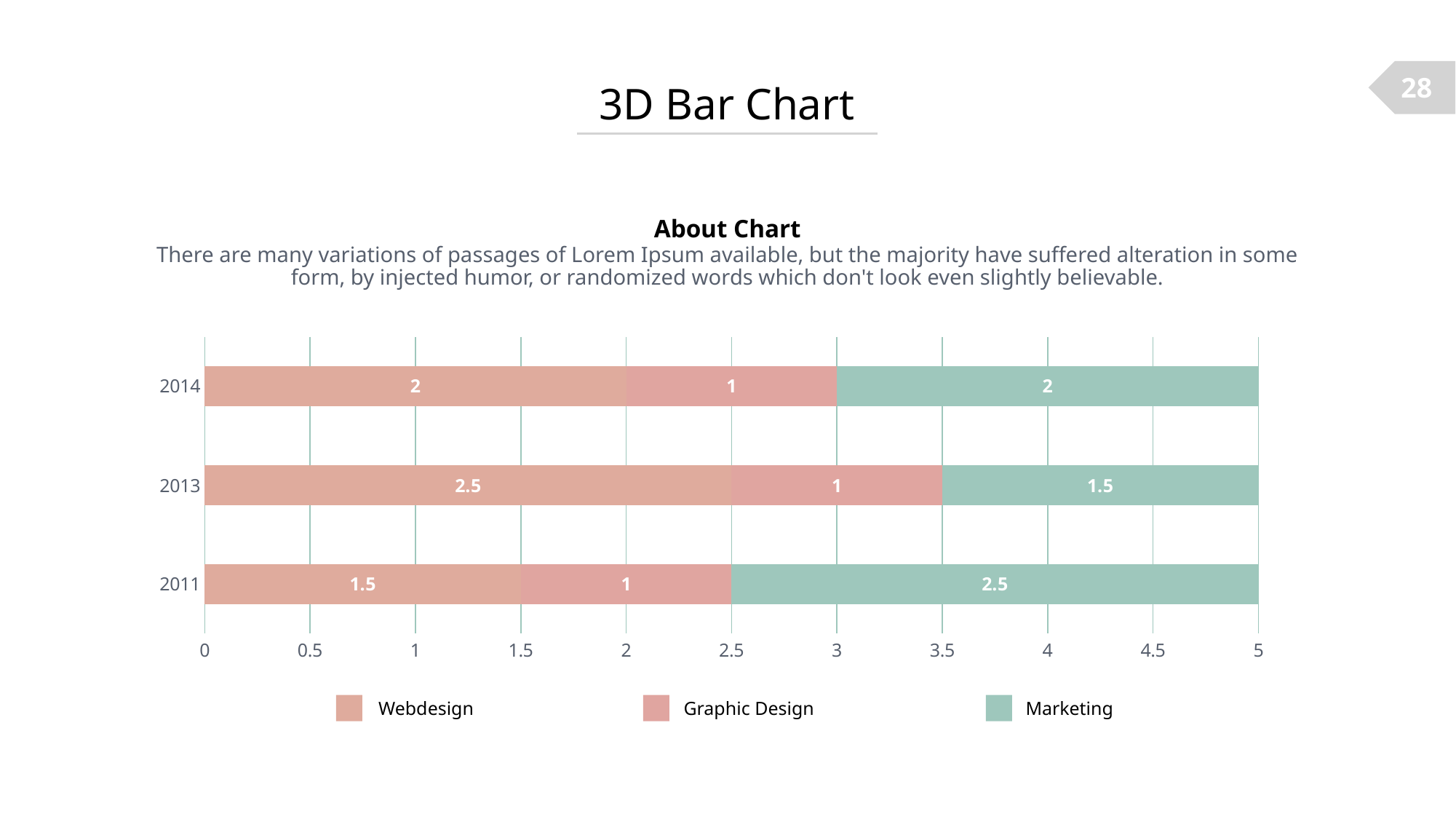
How many series does the legend list? 3 Which year has the highest Webdesign value? 2013 Which is larger, the Webdesign value for 2014 or the Webdesign value for 2011? 2014 What is the Marketing value for 2011? 2.5 Which series is shown in green in the legend? Marketing What is the Webdesign value for 2013? 2.5 How many years are shown on the chart? 3 What is the Graphic Design value for 2014? 1 What is the difference between the Marketing values for 2011 and 2013? 1 What kind of chart is shown on the slide? Stacked bar chart What is the total of the stacked bar for 2013? 5 Which year has the lowest Marketing value? 2013